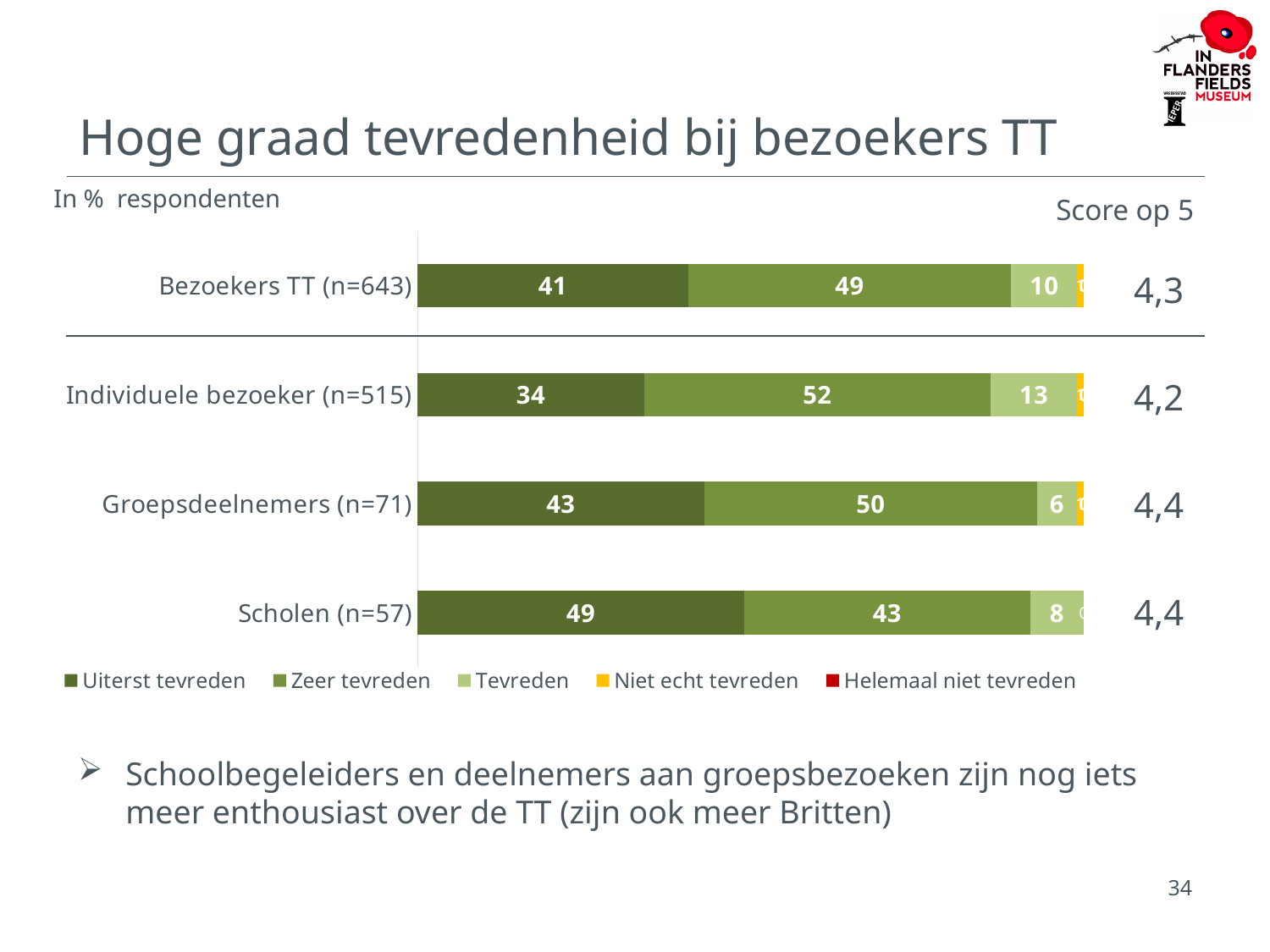
How many categories are shown in the chart? 4 What is the value for Uiterst tevreden for Scholen (n=57)? 49 What is the 'Score op 5' shown next to the bar for Groepsdeelnemers (n=71)? 4,4 How many series does the legend list? 5 What is the value for Uiterst tevreden for Bezoekers TT (n=643)? 41 What is the difference between the Zeer tevreden values for Individuele bezoeker (n=515) and Bezoekers TT (n=643)? 3 Which has the larger Tevreden value: Individuele bezoeker (n=515) or Scholen (n=57)? Individuele bezoeker (n=515) What is the value for Zeer tevreden for Individuele bezoeker (n=515)? 52 Which category has the highest value for Uiterst tevreden? Scholen (n=57) Which category has the lowest value for Uiterst tevreden? Individuele bezoeker (n=515) What is the value for Tevreden for Groepsdeelnemers (n=71)? 6 What kind of chart is shown on the slide? Stacked bar chart